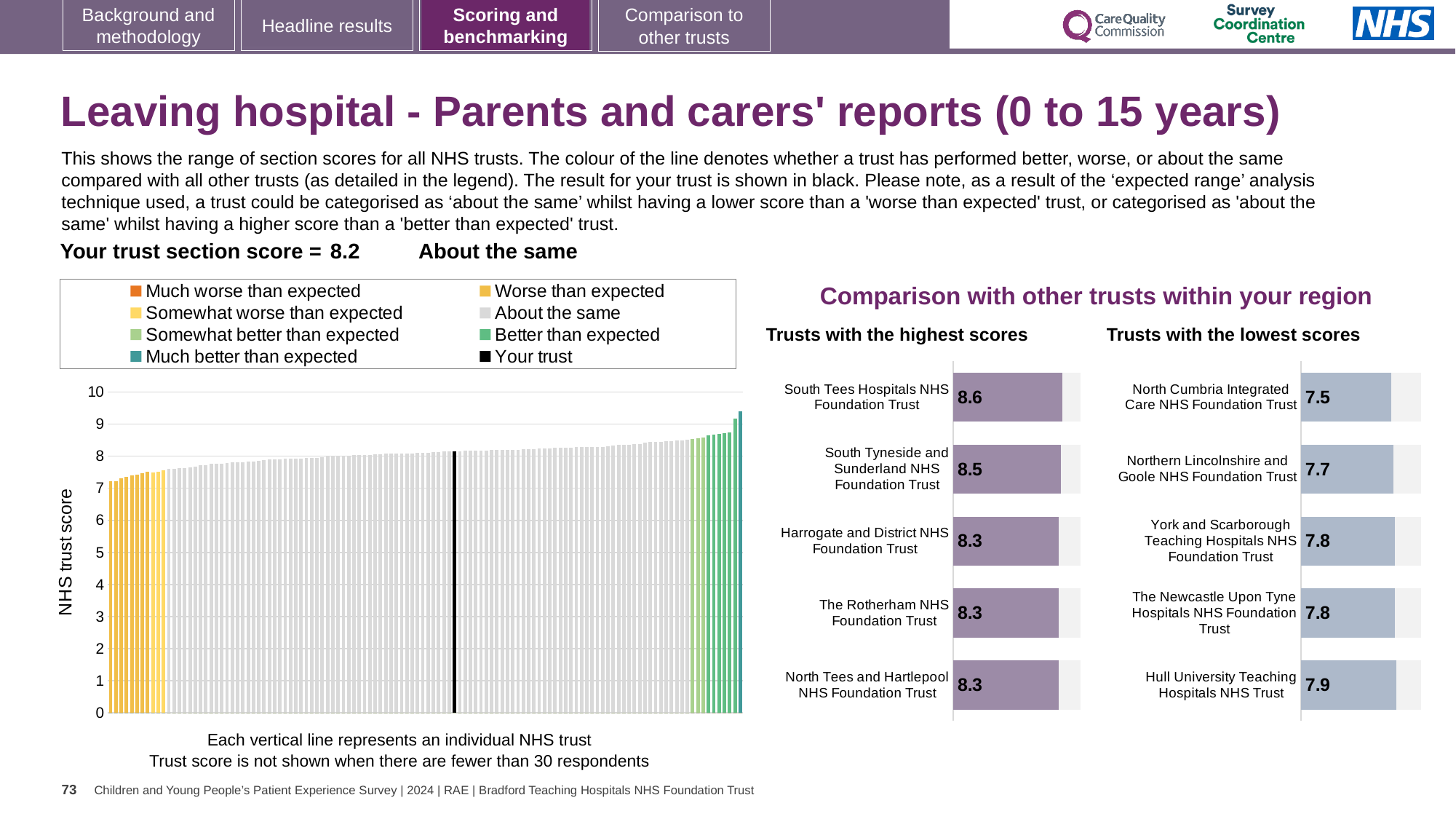
In the 'Trusts with the highest scores' chart, what is the difference between the scores of South Tees Hospitals NHS Foundation Trust and Harrogate and District NHS Foundation Trust? 0.3 In the 'Trusts with the highest scores' chart, what is the score for South Tyneside and Sunderland NHS Foundation Trust? 8.5 In the 'Trusts with the lowest scores' chart, which has the larger score: Hull University Teaching Hospitals NHS Trust or Northern Lincolnshire and Goole NHS Foundation Trust? Hull University Teaching Hospitals NHS Trust In the 'Trusts with the highest scores' chart, which trust has the highest score? South Tees Hospitals NHS Foundation Trust What kind of chart is the 'Trusts with the highest scores' chart? bar chart In the 'NHS trust score' chart on the left, do the trust scores rise or fall from left to right along the x axis? rise In the 'Trusts with the highest scores' chart, how many trusts are listed? 5 How many entries does the legend of the 'NHS trust score' chart on the left list? 8 In the 'Trusts with the highest scores' chart, what is the score for South Tees Hospitals NHS Foundation Trust? 8.6 In the 'Trusts with the lowest scores' chart, what is the score for North Cumbria Integrated Care NHS Foundation Trust? 7.5 In the 'Trusts with the lowest scores' chart, which trust has the lowest score? North Cumbria Integrated Care NHS Foundation Trust In the 'Trusts with the lowest scores' chart, what is the difference between the scores of Hull University Teaching Hospitals NHS Trust and North Cumbria Integrated Care NHS Foundation Trust? 0.4